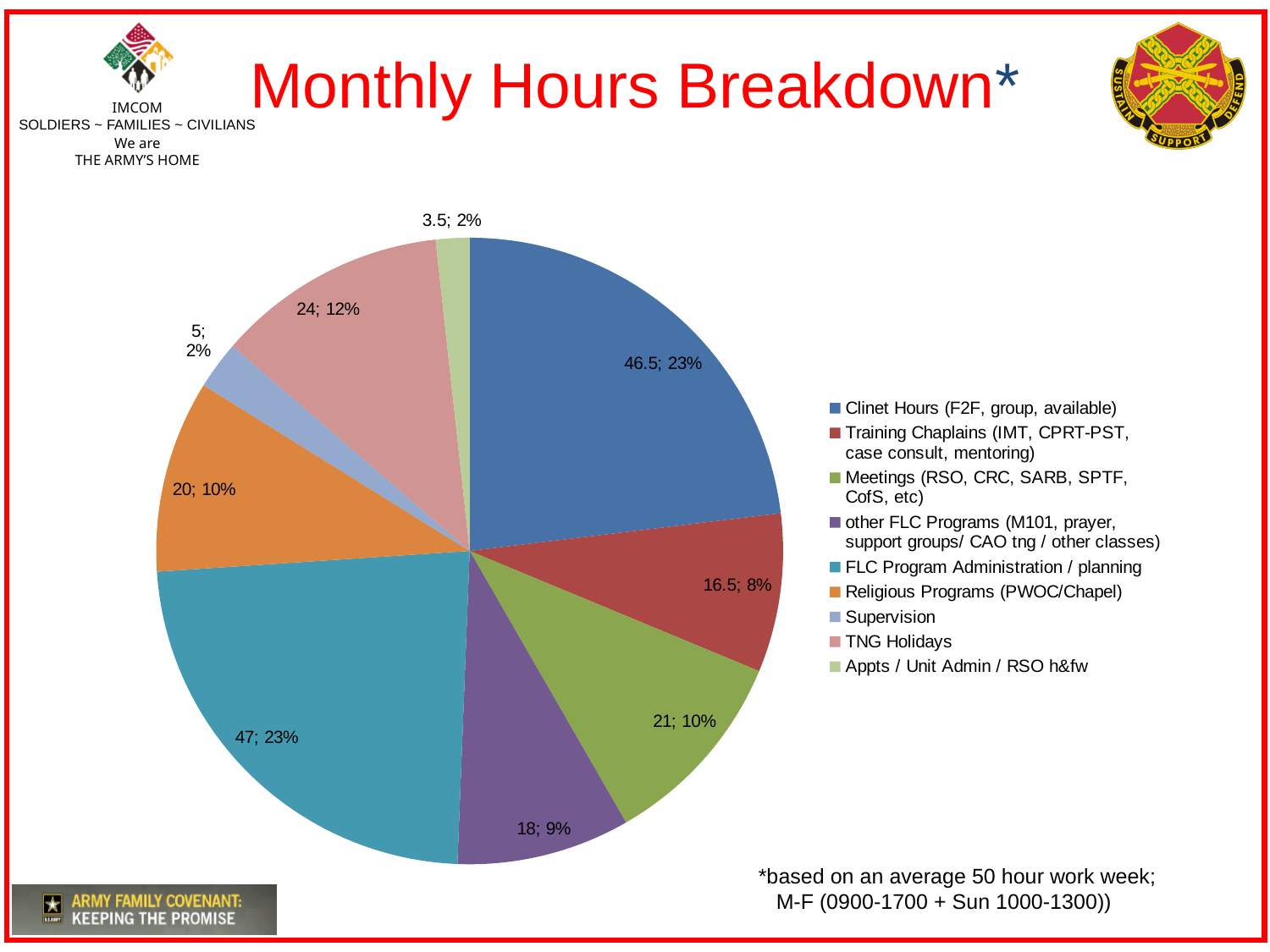
Which category has the smallest slice of the pie? Appts / Unit Admin / RSO h&fw What value is shown for the TNG Holidays slice? 24 What is the difference between the value for TNG Holidays and the value for Supervision? 19 What kind of chart is shown on the slide? pie chart What is the title of the chart? Monthly Hours Breakdown* What value is shown for the Clinet Hours (F2F, group, available) slice? 46.5 Which category has the largest slice of the pie? FLC Program Administration / planning How many slices does the pie chart have? 9 Which is larger, the value for Meetings (RSO, CRC, SARB, SPTF, CofS, etc) or the value for other FLC Programs (M101, prayer, support groups/ CAO tng / other classes)? Meetings (RSO, CRC, SARB, SPTF, CofS, etc) What percentage share of the pie does FLC Program Administration / planning have? 23% What percentage share of the pie does Religious Programs (PWOC/Chapel) have? 10% What value is shown for the Training Chaplains (IMT, CPRT-PST, case consult, mentoring) slice? 16.5